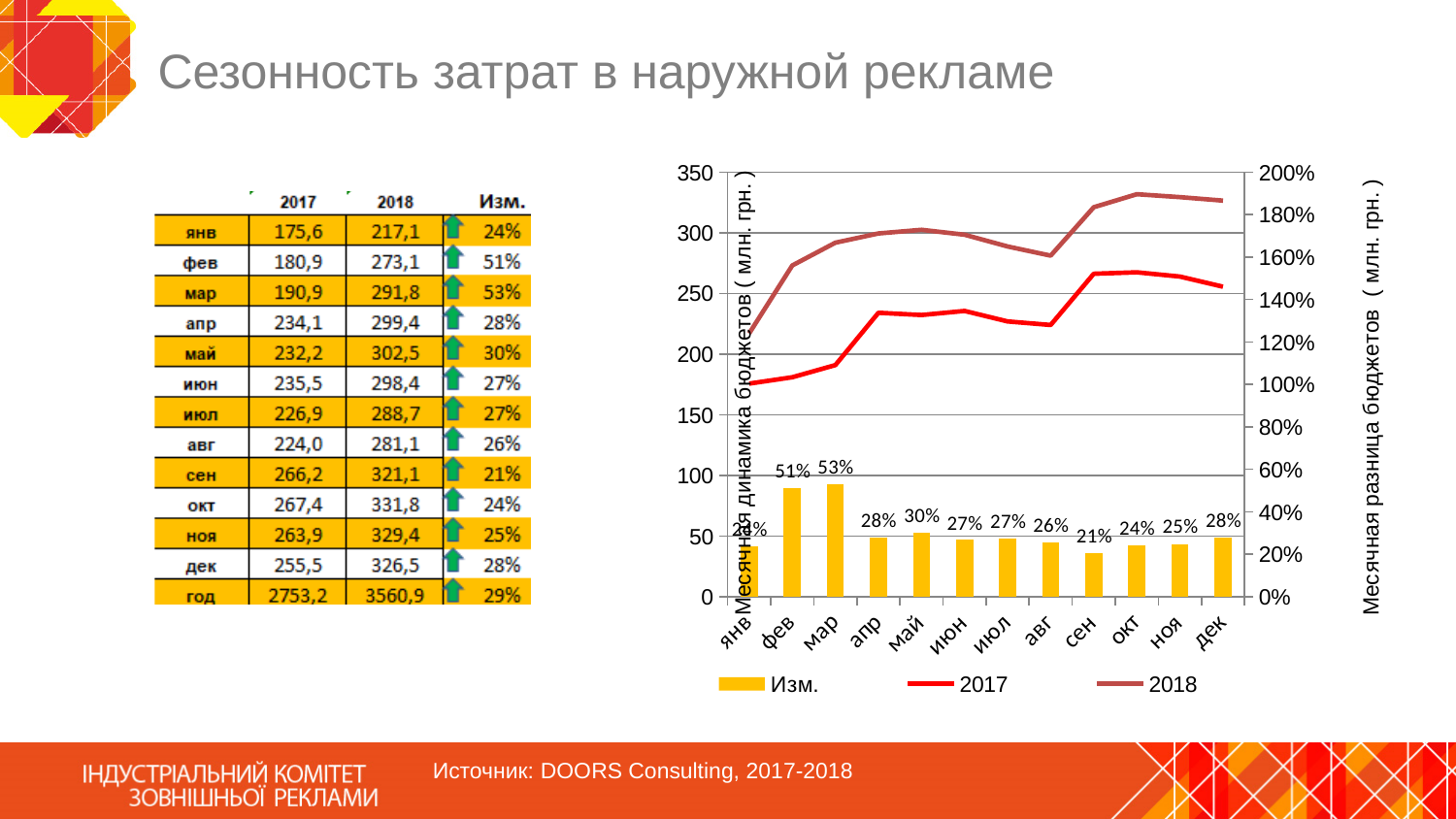
Does the 2018 line rise or fall from янв to мар? rise What is the value of the Изм. bar for сен? 21% Which month has the lowest Изм. bar? сен What is the value of the Изм. bar for мар? 53% Which month has the highest Изм. bar? мар Is the 2017 line value for янв greater or less than 200? less What is the difference between the Изм. values for мар and фев? 2% What is the value of the Изм. bar for дек? 28% Is the 2018 line value for окт greater or less than 300? greater How many months are shown on the x axis? 12 How many series does the legend list? 3 Which has a larger Изм. value, апр or май? май